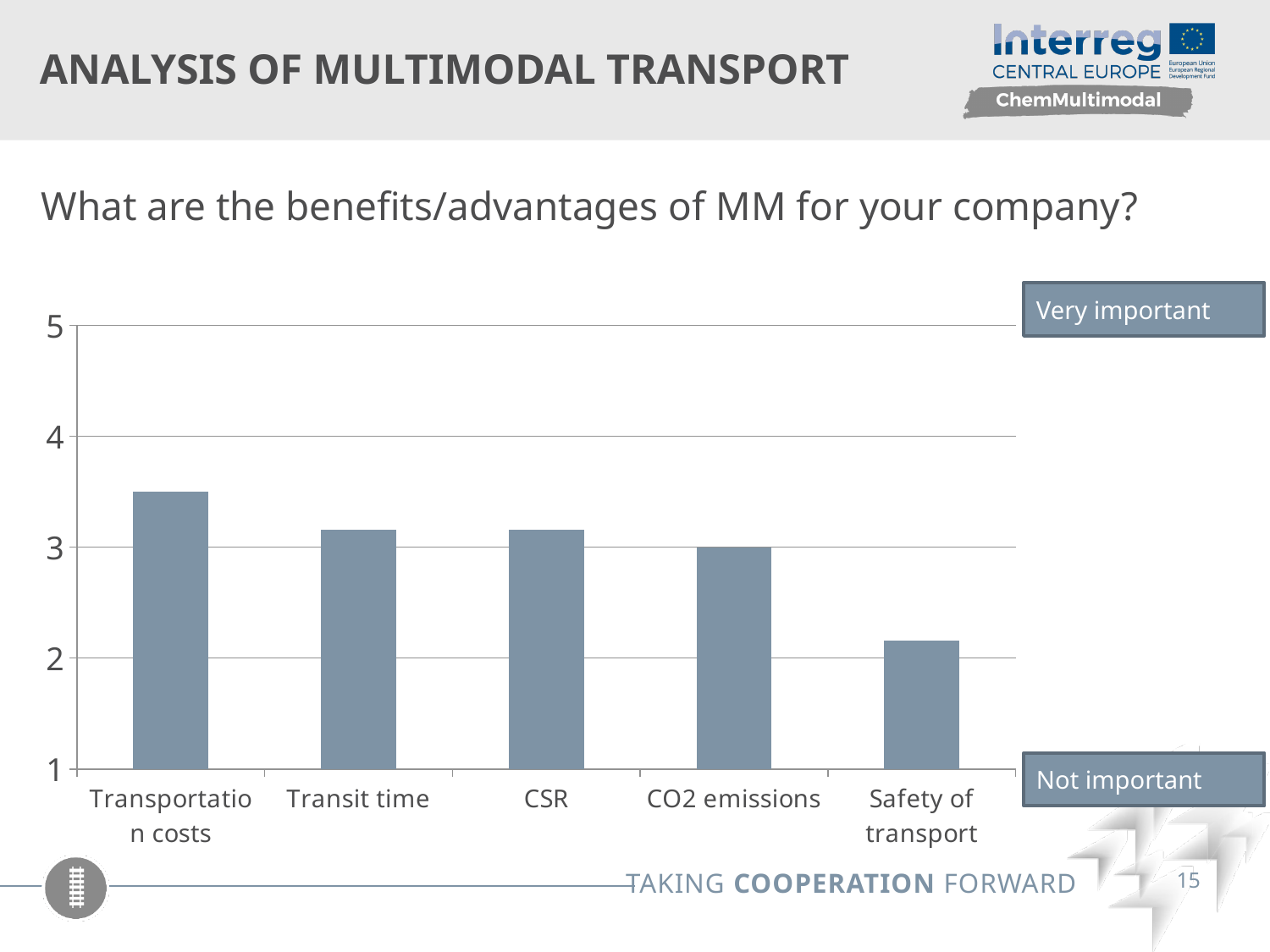
Is the value for Transit time greater or less than 3? greater Is the value for Safety of transport greater or less than 2? greater Which is larger, the value for CSR or the value for Safety of transport? CSR Is the value for Safety of transport greater or less than 3? less How many categories are shown on the x axis of the chart? 5 Which category has the highest bar in the chart? Transportation costs Which is larger, the value for Transportation costs or the value for CO2 emissions? Transportation costs What kind of chart is shown on the slide? bar chart What label is shown at the top of the y axis scale, next to the value 5? Very important Which category has the lowest bar in the chart? Safety of transport